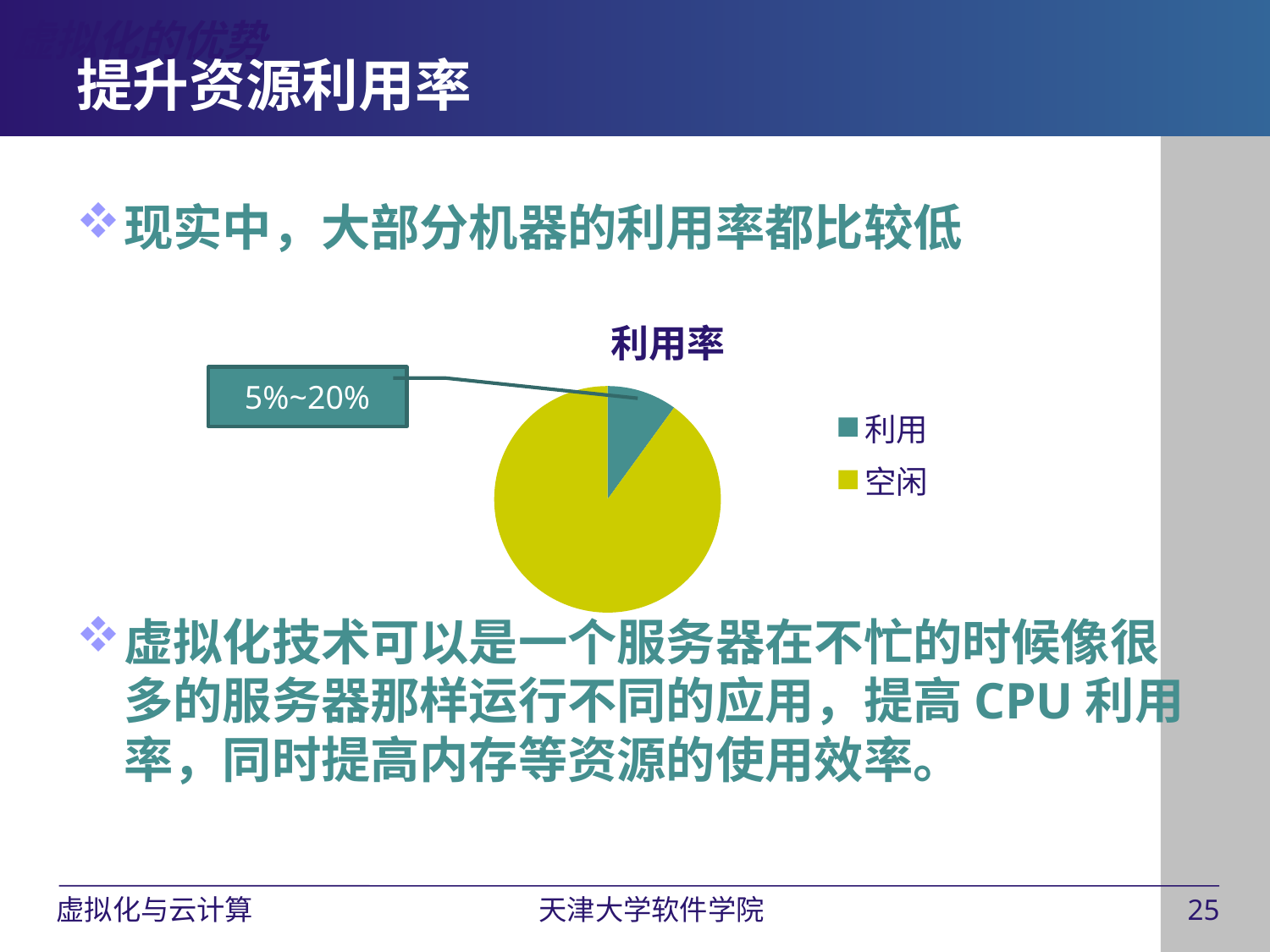
What kind of chart is shown on the slide? pie chart What range does the callout label attached to the 利用 slice show? 5%~20% What is the title of the chart? 利用率 Which is larger in the pie chart, 利用 or 空闲? 空闲 How many entries does the chart legend list? 2 How many slices does the pie chart have? 2 Which slice of the pie chart is the smallest? 利用 Which slice of the pie chart is the largest? 空闲